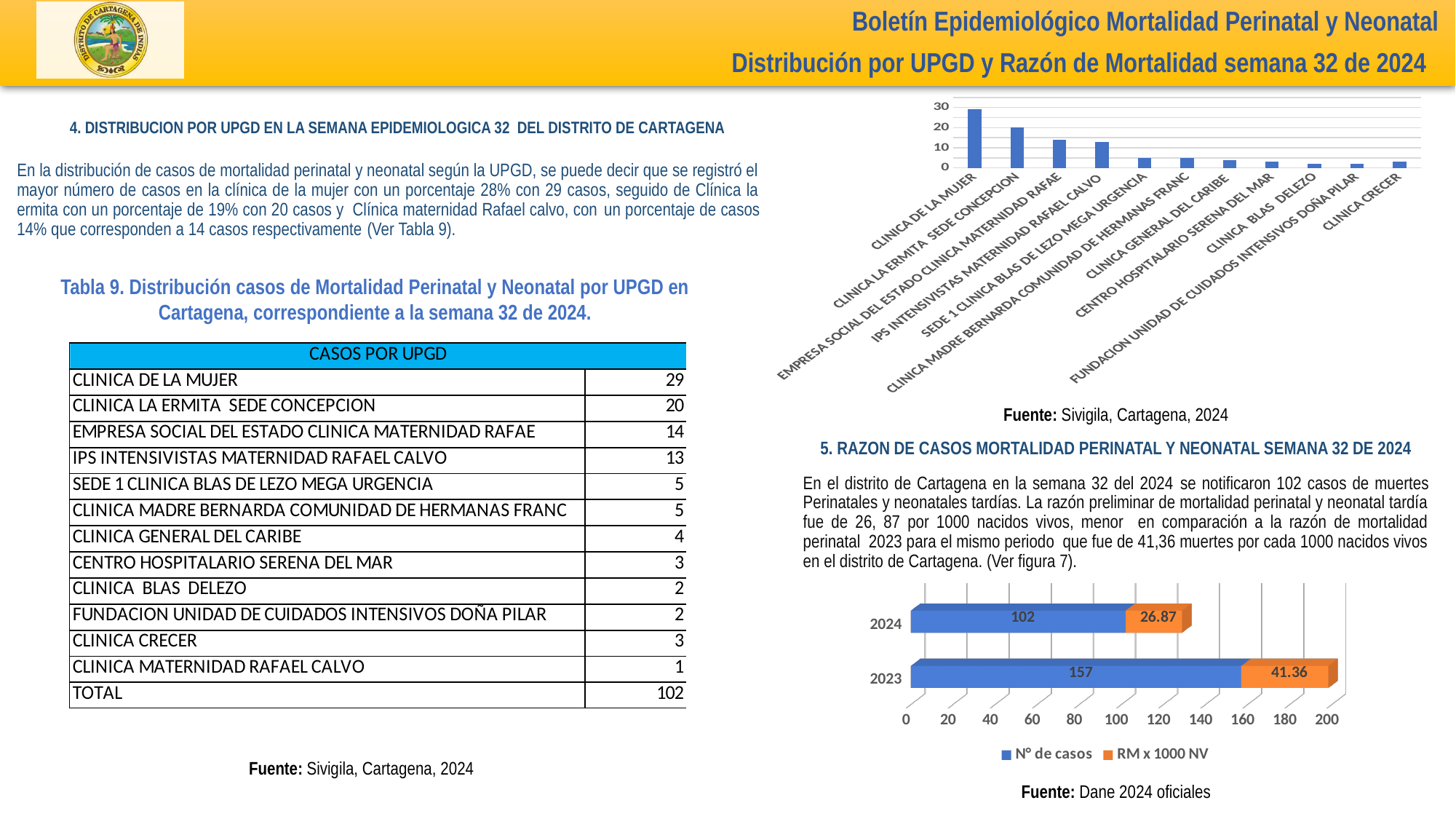
In the top-right chart, is the value for CLINICA LA ERMITA SEDE CONCEPCION greater or less than 10? greater In the bottom-right chart, what is the RM x 1000 NV value for 2023? 41.36 How many bars are plotted in the top-right chart? 11 In the bottom-right chart, what is the difference in N° de casos between 2023 and 2024? 55 In the bottom-right chart, what is the RM x 1000 NV value for 2024? 26.87 In the bottom-right chart, which year has the higher N° de casos, 2023 or 2024? 2023 In the top-right chart, is the value for CLINICA GENERAL DEL CARIBE greater or less than 10? less What kind of chart is the bottom-right chart? Stacked bar chart How many series does the legend of the bottom-right chart list? 2 In the top-right chart, which category has the highest bar? CLINICA DE LA MUJER In the bottom-right chart, what is the N° de casos value for 2024? 102 In the bottom-right chart, what is the total of the stacked bar for 2023? 198.36